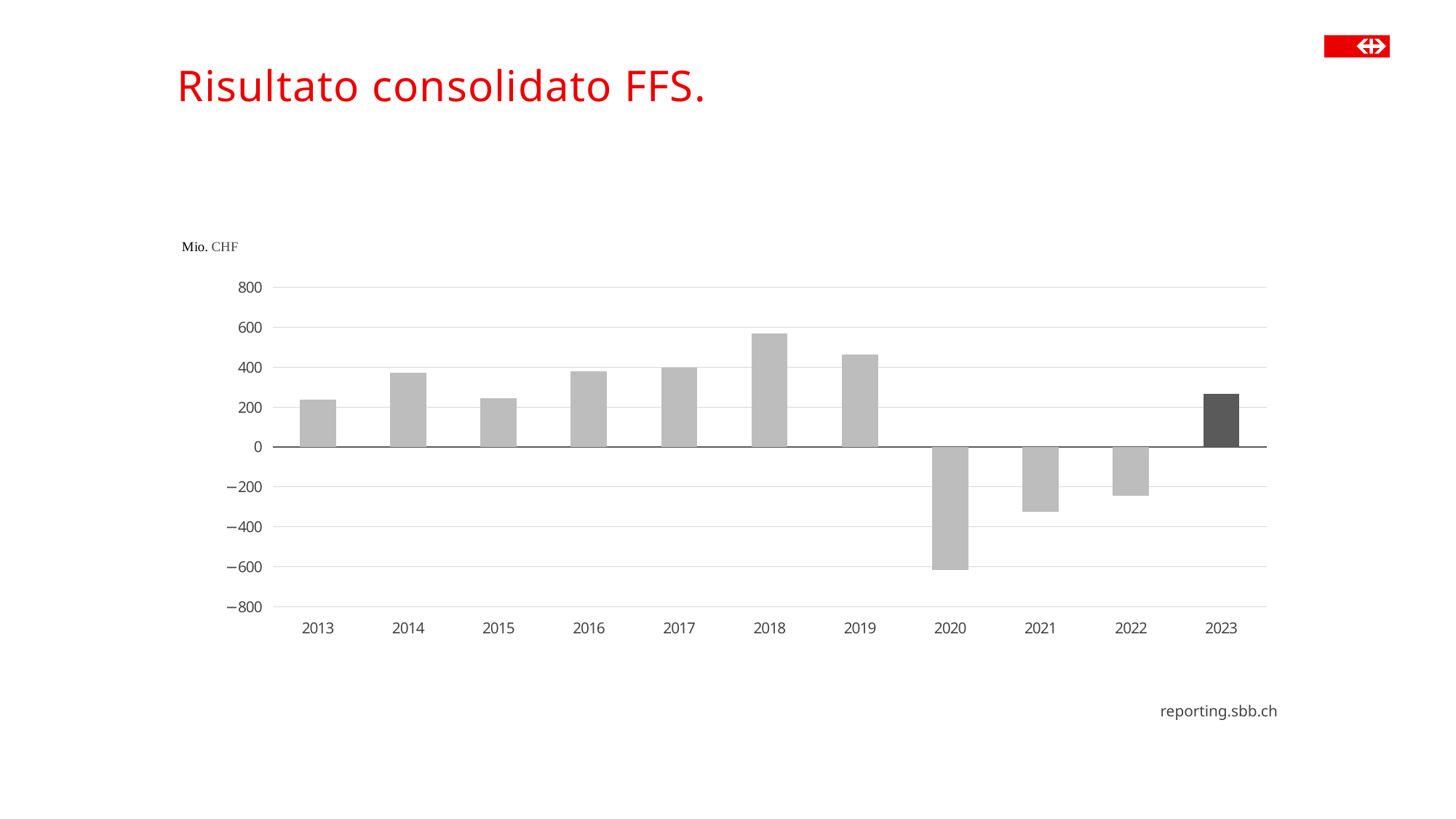
What kind of chart is shown on the slide? bar chart Does the value rise or fall from 2019 to 2020? fall Which year has the highest value in the chart? 2018 Which year has the lowest value in the chart? 2020 Is the value for 2013 greater or less than 200? greater Is the value for 2018 greater or less than 400? greater Which year has the larger value, 2013 or 2014? 2014 Which year has the larger value, 2018 or 2019? 2018 How many years are shown on the x axis of the chart? 11 Is the value for 2020 greater or less than −400? less What unit is shown above the y axis of the chart? Mio. CHF